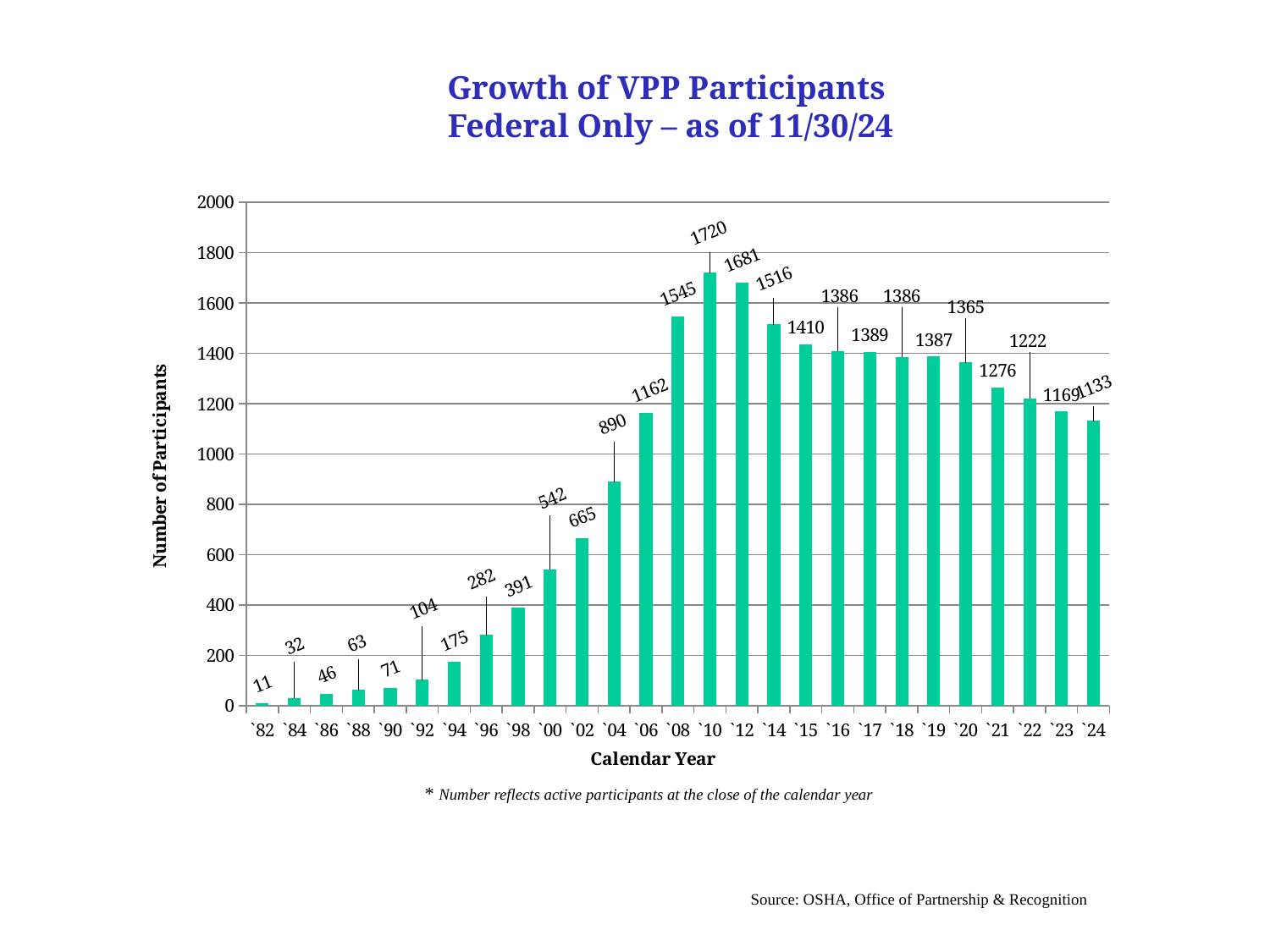
What is the number of participants for `04? 890 What is the difference in participants between `23 and `24? 36 Which calendar year has the highest number of participants? `10 Which year has more participants, `08 or `12? `12 What kind of chart is shown on the slide? Bar chart What is the number of participants for `10? 1720 What is the title of the vertical axis? Number of Participants Which calendar year has the lowest number of participants? `82 Do the values rise or fall from `82 to `10? Rise How many calendar years are shown on the x axis? 27 What is the difference in participants between `10 and `12? 39 What is the number of participants for `24? 1133